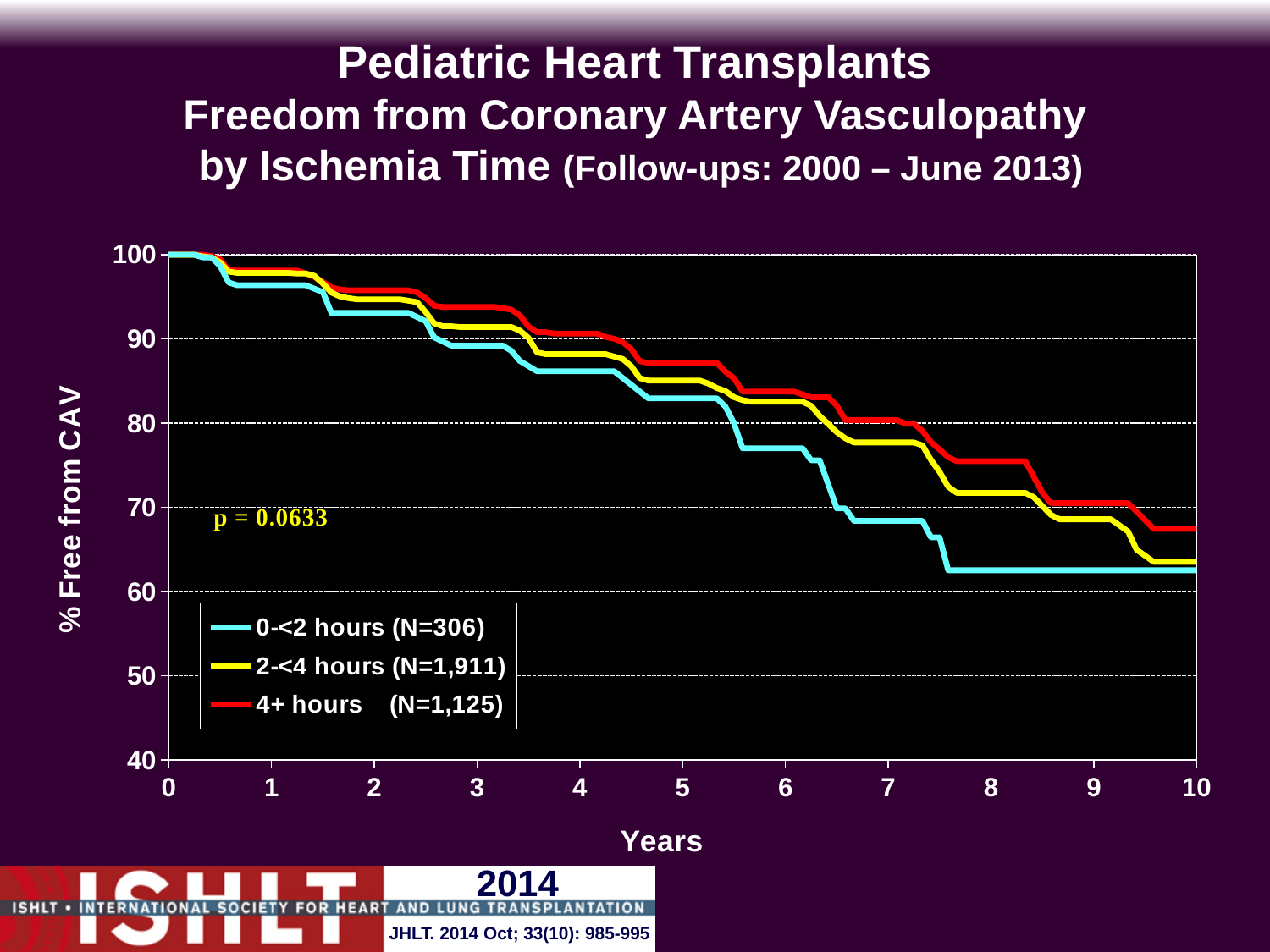
What p-value is printed on the chart? p = 0.0633 Is the value for 2-<4 hours at year 5 greater or less than 80? greater Is the value for 0-<2 hours at year 10 greater or less than 70? less At year 7, which series has the lowest % free from CAV? 0-<2 hours (N=306) At year 10, which series has the highest % free from CAV? 4+ hours (N=1,125) Is the value for 0-<2 hours at year 6 greater or less than 80? less Do the values for all three series rise or fall as years increase? fall What kind of chart is shown on the slide? line chart How many series does the legend list? 3 What is the sample size (N) for the 2-<4 hours group shown in the legend? N=1,911